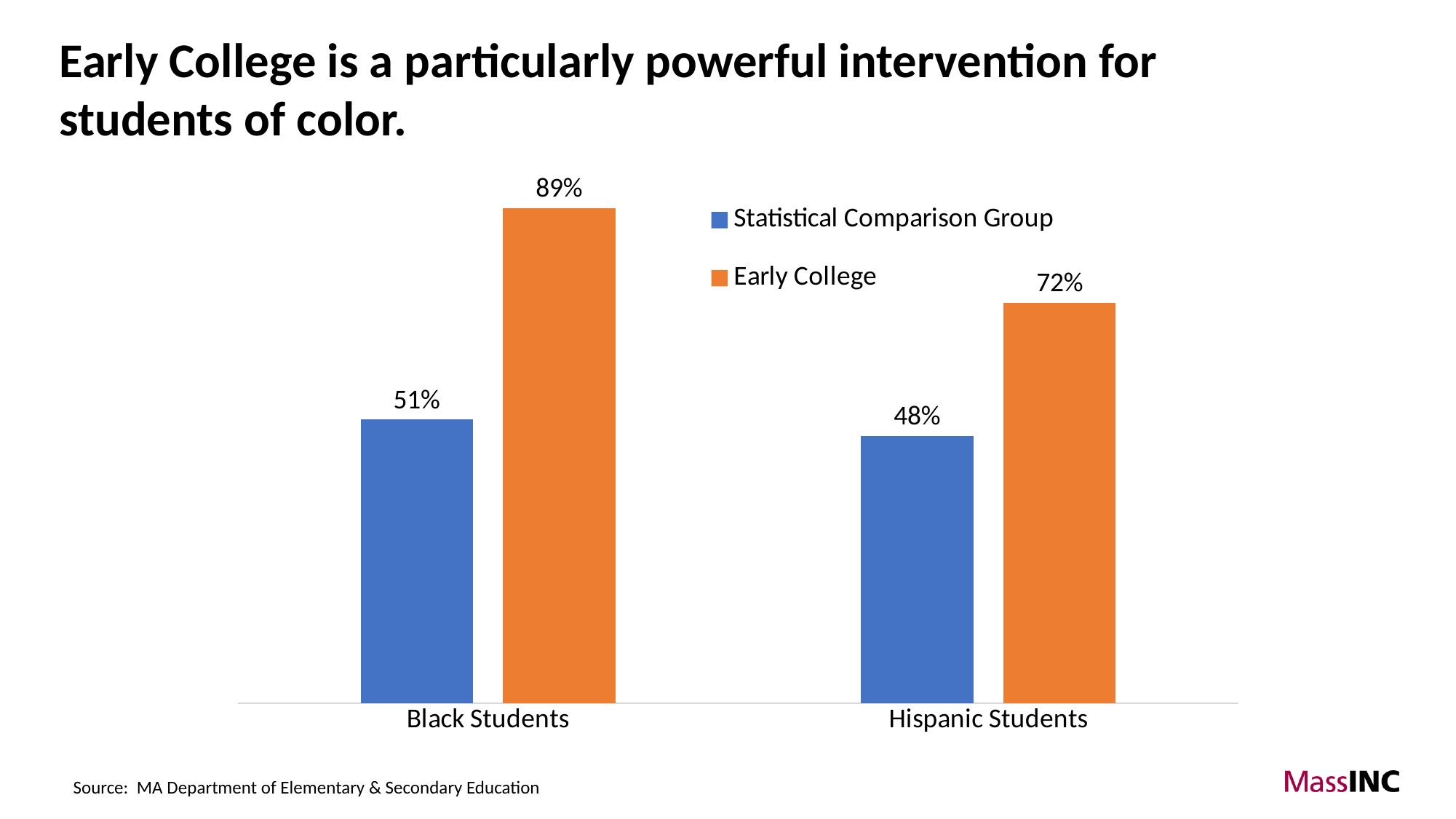
Which is larger: the Early College value for Hispanic Students or the Statistical Comparison Group value for Black Students? Early College value for Hispanic Students What is the Statistical Comparison Group value for Hispanic Students? 48% What kind of chart is shown on the slide? Bar chart What is the difference between the Early College and Statistical Comparison Group values for Hispanic Students? 24 percentage points What is the Early College value for Hispanic Students? 72% What is the Statistical Comparison Group value for Black Students? 51% How many categories are shown on the x axis? 2 How many series does the legend list? 2 Which category has the highest Early College value? Black Students What is the difference between the Early College and Statistical Comparison Group values for Black Students? 38 percentage points Which category has the lowest Statistical Comparison Group value? Hispanic Students What is the Early College value for Black Students? 89%